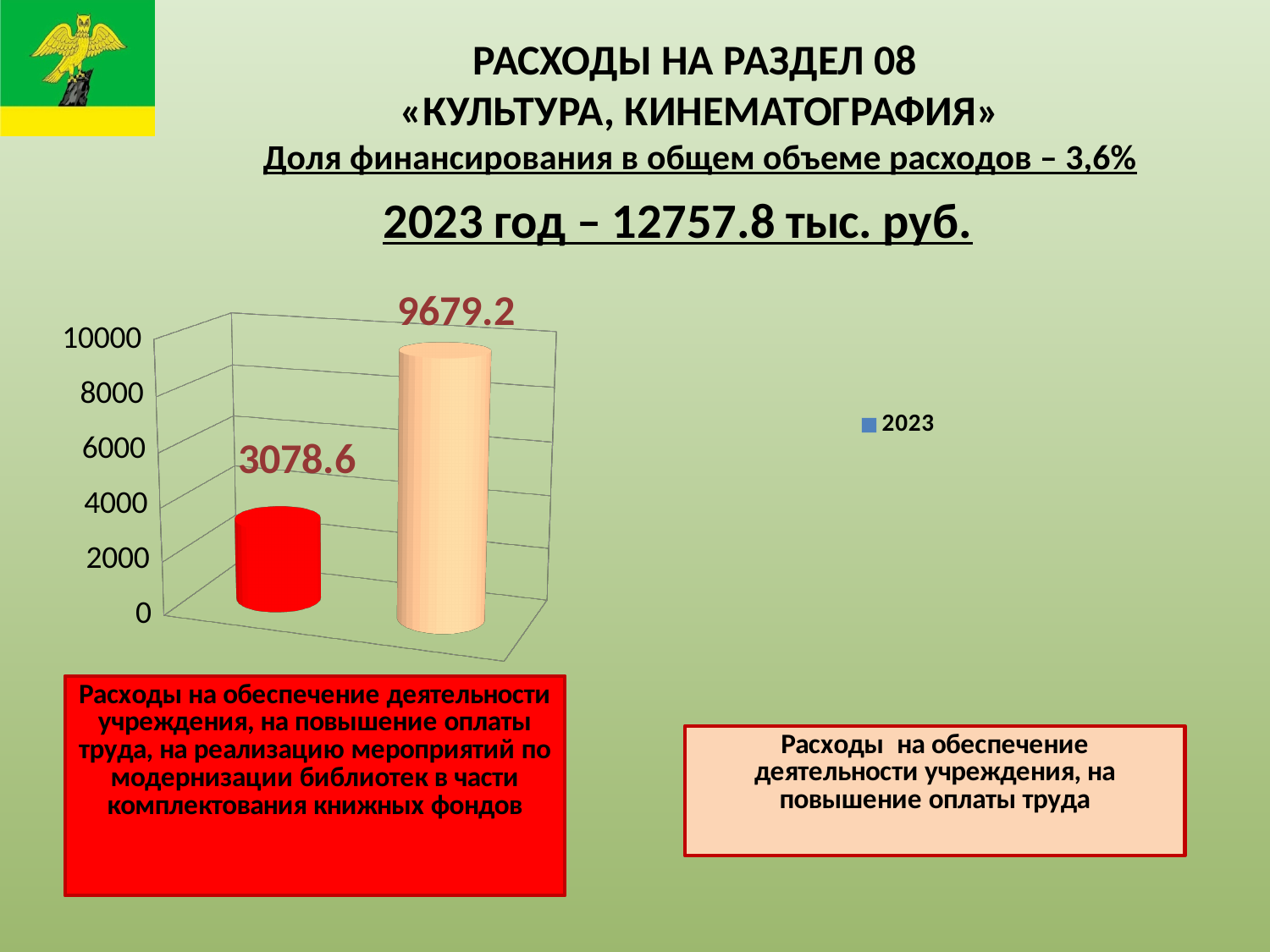
How many series does the chart legend list? 1 Is the value of the peach bar greater or less than 8000? greater What value is shown on the peach (light orange) bar in the chart? 9679.2 Which bar has the lowest value in the chart, the red one or the peach one? the red one (3078.6) How many bars are plotted in the chart? 2 Is the value of the red bar greater or less than 4000? less What kind of chart is shown on the slide? bar chart Is the value of the red bar larger or smaller than the value of the peach bar? smaller What year is listed in the chart legend? 2023 What value is shown on the red bar in the chart? 3078.6 Which bar has the highest value in the chart, the red one or the peach one? the peach one (9679.2) What is the difference between the values of the peach bar and the red bar? 6600.6